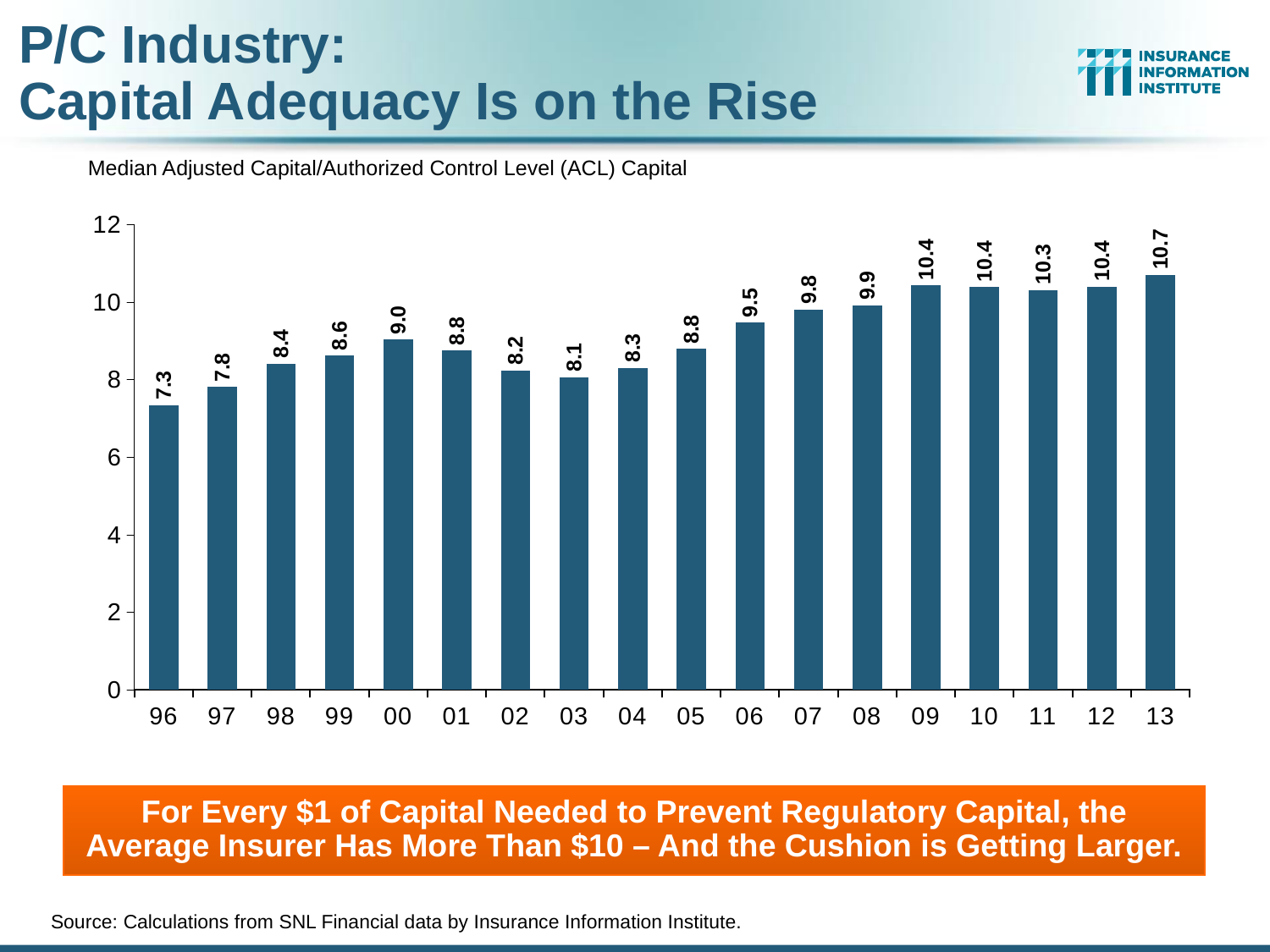
What is the Median Adjusted Capital/ACL Capital value for 96? 7.3 Is the value for 07 greater or less than 10? less What is the label above the chart describing the plotted measure? Median Adjusted Capital/Authorized Control Level (ACL) Capital Which is larger, the value for 00 or the value for 02? 00 What is the value shown for 13? 10.7 What is the difference between the values for 13 and 96? 3.4 What kind of chart is shown on the slide? bar chart How many years are shown on the x axis? 18 Do the values generally rise or fall from 96 to 13? rise Which year has the highest value? 13 What is the value shown for 03? 8.1 Which year has the lowest value? 96